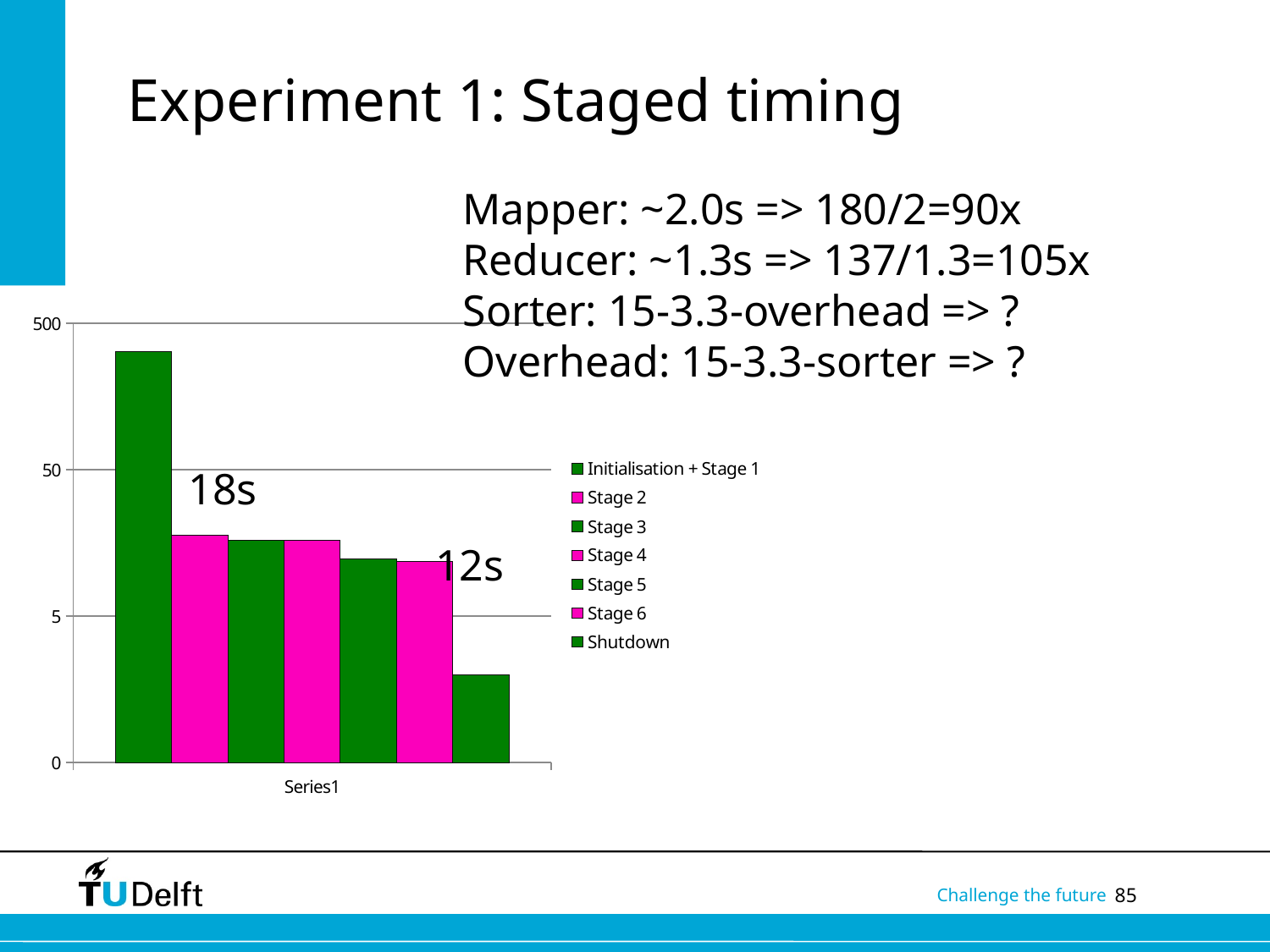
Is the value for Shutdown greater or less than 5? less What colour is the Stage 4 series in the legend? Magenta Is the value for Initialisation + Stage 1 greater or less than 50? greater Which series has the shortest bar in the chart? Shutdown Which series has the tallest bar in the chart? Initialisation + Stage 1 Which is larger, the value for Stage 2 or the value for Shutdown? Stage 2 How many series does the chart legend list? 7 Is the value for Stage 2 greater or less than 50? less What label appears on the category axis below the bars? Series1 How many bars are plotted in the chart? 7 What kind of chart is shown on the slide? Bar chart